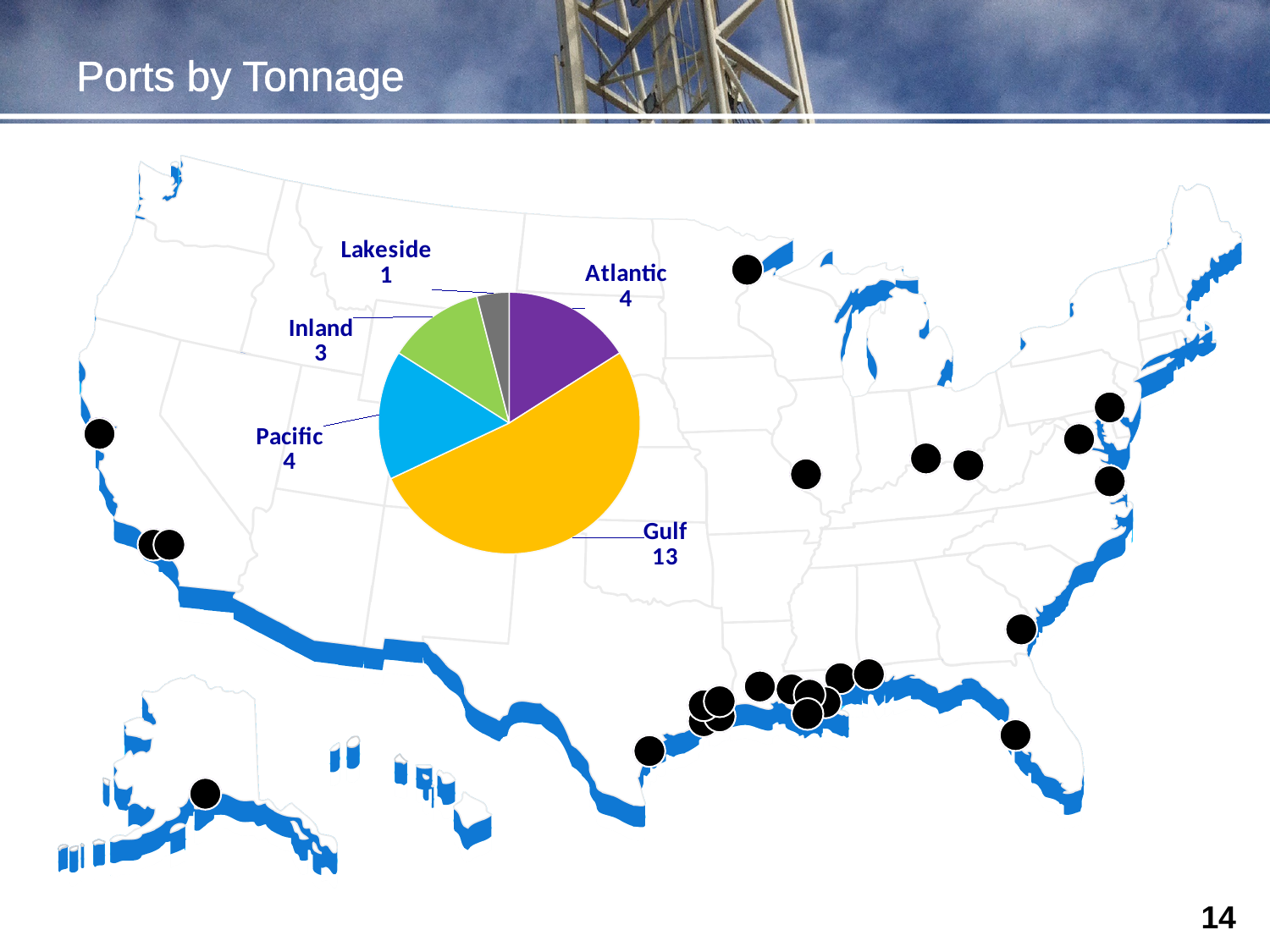
What kind of chart is shown on the slide? Pie chart What is the title of the slide containing the pie chart? Ports by Tonnage What is the value for Gulf in the pie chart? 13 What share of the pie does the Gulf slice represent? 52% What is the difference between the values for Gulf and Atlantic? 9 What is the value for Lakeside in the pie chart? 1 What is the value for Inland in the pie chart? 3 Which category has the largest slice of the pie chart? Gulf Which is larger, the value for Inland or the value for Pacific? Pacific Which category has the smallest slice of the pie chart? Lakeside How many slices does the pie chart have? 5 What is the total of all the values shown in the pie chart? 25